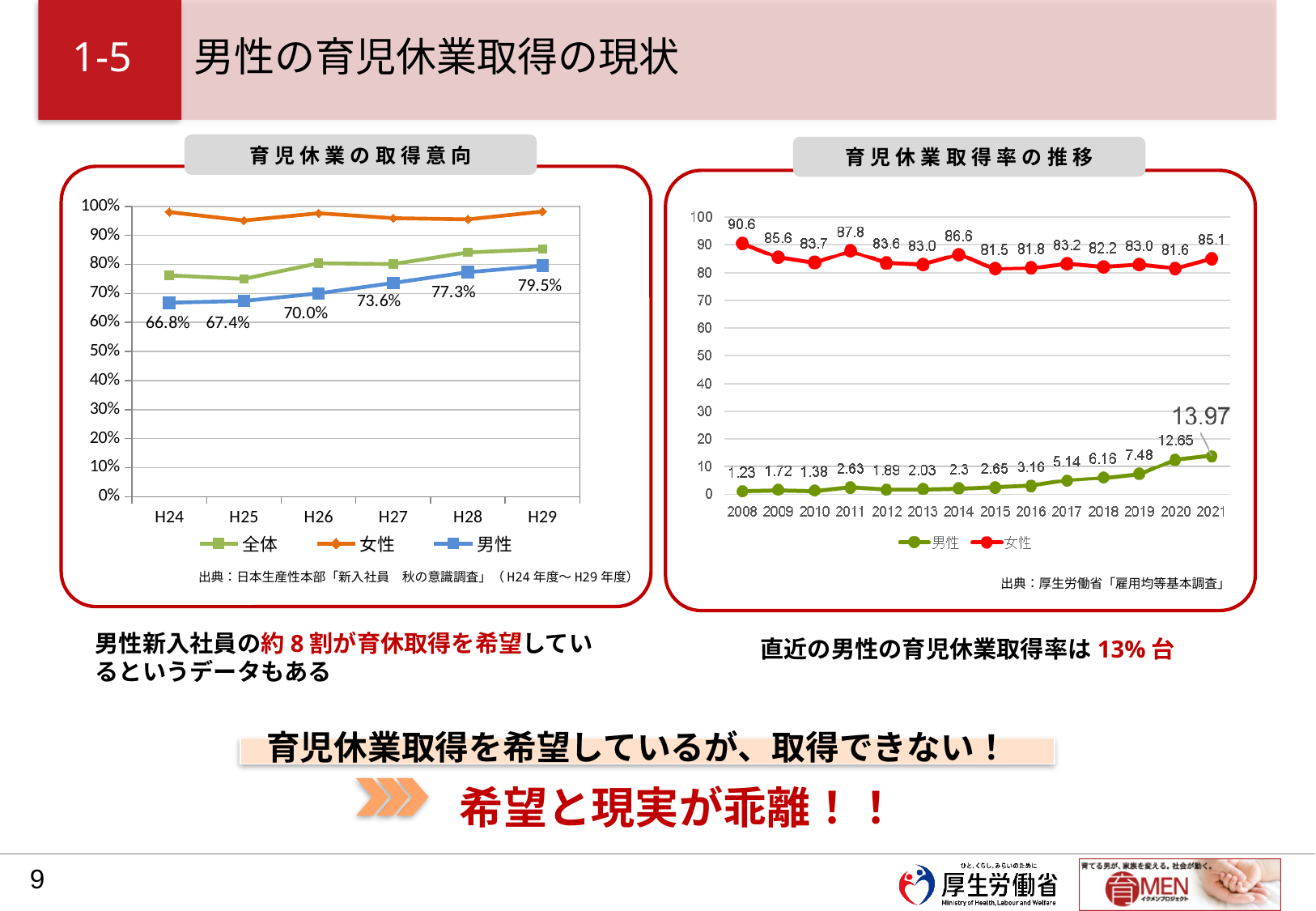
In the 育児休業取得率の推移 chart, what is the value for 男性 in 2021? 13.97 In the 育児休業取得率の推移 chart, what is the value for 女性 in 2008? 90.6 In the 育児休業の取得意向 chart, what is the value for 男性 in H29? 79.5% In the 育児休業取得率の推移 chart, which year has the highest value for 女性? 2008 In the 育児休業取得率の推移 chart, which year has the lowest value for 男性? 2008 In the 育児休業取得率の推移 chart, what is the difference between the 男性 values for 2021 and 2020? 1.32 In the 育児休業の取得意向 chart, what is the value for 男性 in H24? 66.8% What type of chart is the 育児休業取得率の推移 chart? line chart In the 育児休業の取得意向 chart, how many series does the legend list? 3 In the 育児休業の取得意向 chart, is the value for 女性 in H26 greater or less than 90%? greater In the 育児休業取得率の推移 chart, how many years are plotted on the x axis? 14 In the 育児休業の取得意向 chart, does the 男性 line rise or fall from H24 to H29? rise